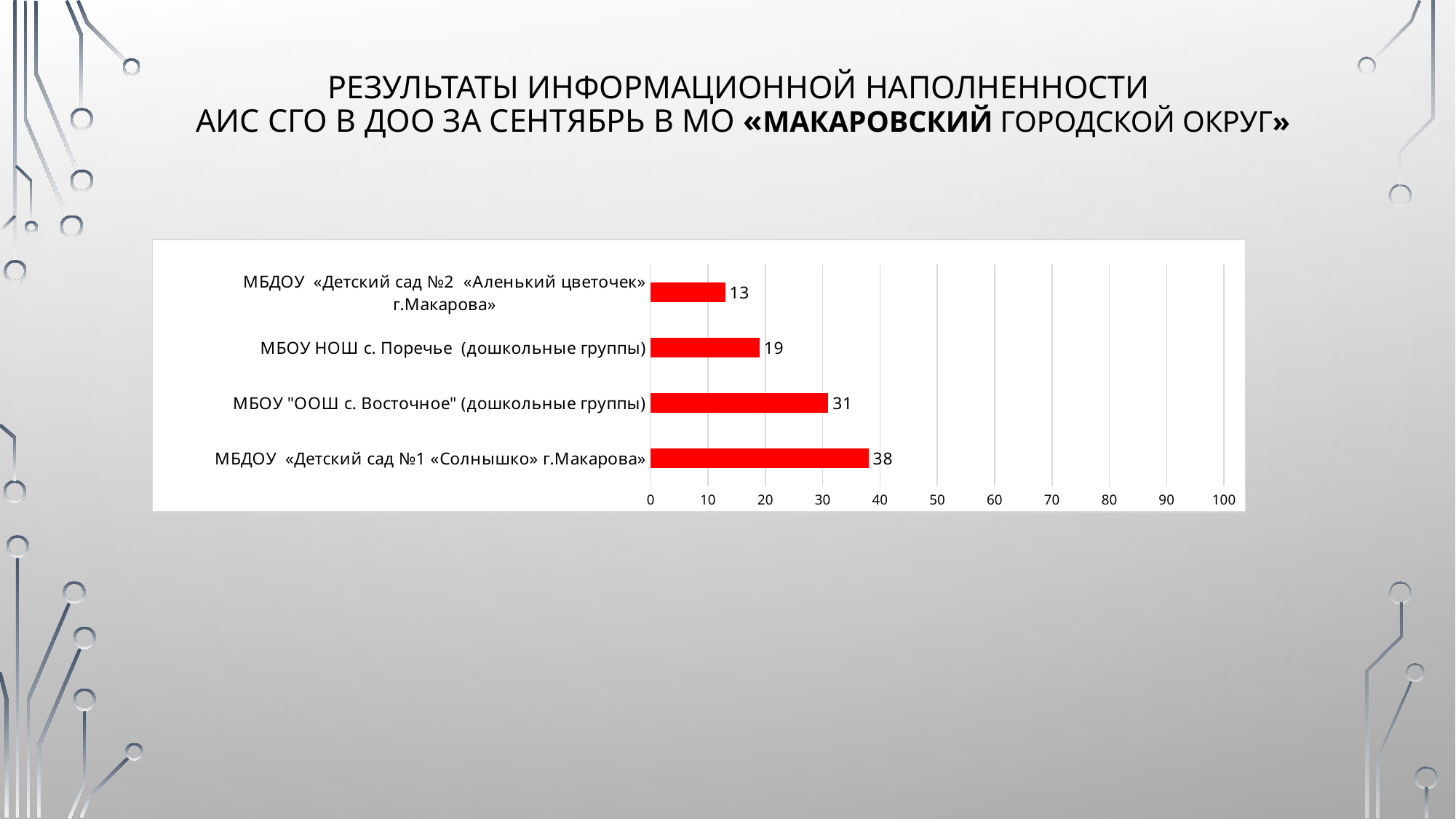
Which has a larger value: МБОУ НОШ с. Поречье (дошкольные группы) or МБОУ "ООШ с. Восточное" (дошкольные группы)? МБОУ "ООШ с. Восточное" (дошкольные группы) Which category has the lowest value? МБДОУ «Детский сад №2 «Аленький цветочек» г.Макарова» What is the difference between the values for МБОУ НОШ с. Поречье (дошкольные группы) and МБДОУ «Детский сад №2 «Аленький цветочек» г.Макарова»? 6 What kind of chart is shown on the slide? Bar chart Which category has the highest value? МБДОУ «Детский сад №1 «Солнышко» г.Макарова» What is the value for МБОУ НОШ с. Поречье (дошкольные группы)? 19 What is the value for МБДОУ «Детский сад №1 «Солнышко» г.Макарова»? 38 What is the value for МБОУ "ООШ с. Восточное" (дошкольные группы)? 31 What is the value for МБДОУ «Детский сад №2 «Аленький цветочек» г.Макарова»? 13 What is the maximum value shown on the horizontal axis? 100 How many categories are shown in the chart? 4 What is the difference between the values for МБДОУ «Детский сад №1 «Солнышко» г.Макарова» and МБОУ "ООШ с. Восточное" (дошкольные группы)? 7